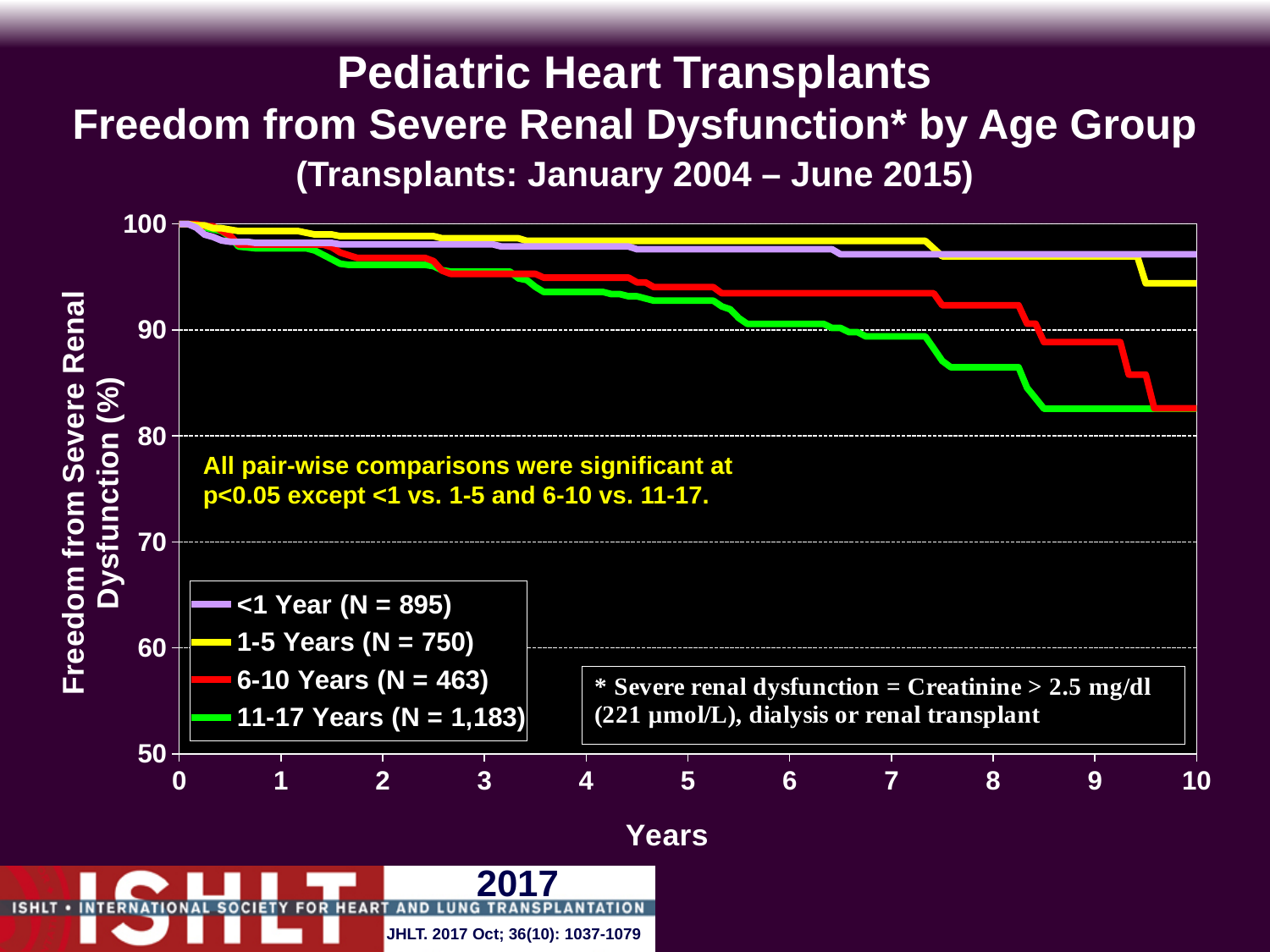
How many series does the legend list? 4 At 8 years, which is higher: the 6-10 Years curve or the 11-17 Years curve? 6-10 Years Which age group has the lowest freedom from severe renal dysfunction at 8 years? 11-17 Years What colour is the line for the <1 Year group? purple Do the curves rise or fall as years since transplant increase? fall Is the value for 11-17 Years at 8 years greater or less than 90? less Is the value for 11-17 Years at 10 years greater or less than 90? less What kind of chart is shown on the slide? line chart Is the value for 1-5 Years at 10 years greater or less than 90? greater What is the N shown in the legend for the 11-17 Years group? 1,183